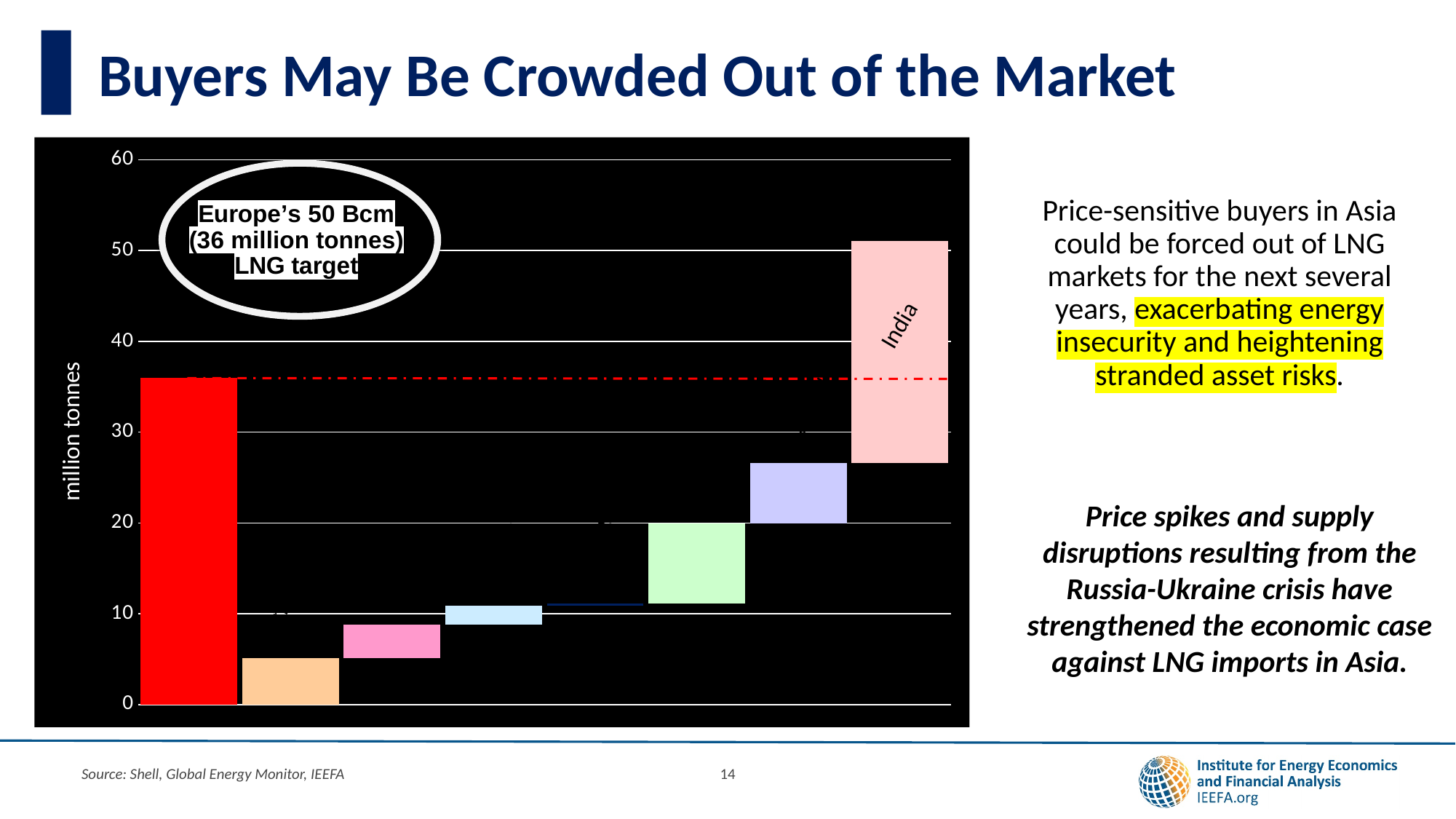
Is the top of the red bar on the far left greater or less than 30 million tonnes? greater Which country is labelled on the rightmost bar of the chart? India What is the highest value shown on the vertical axis of the chart? 60 What is the label on the vertical axis of the chart? million tonnes Is the top of the India bar greater or less than 40 million tonnes? greater What kind of chart is shown on the slide? bar chart Do the bar tops generally rise or fall moving from left to right after the first red bar? rise What is Europe's LNG target in Bcm, as stated in the chart annotation? 50 Bcm Is the top of the red bar on the far left greater or less than 40 million tonnes? less According to the annotation, how many million tonnes does Europe's 50 Bcm LNG target correspond to? 36 million tonnes